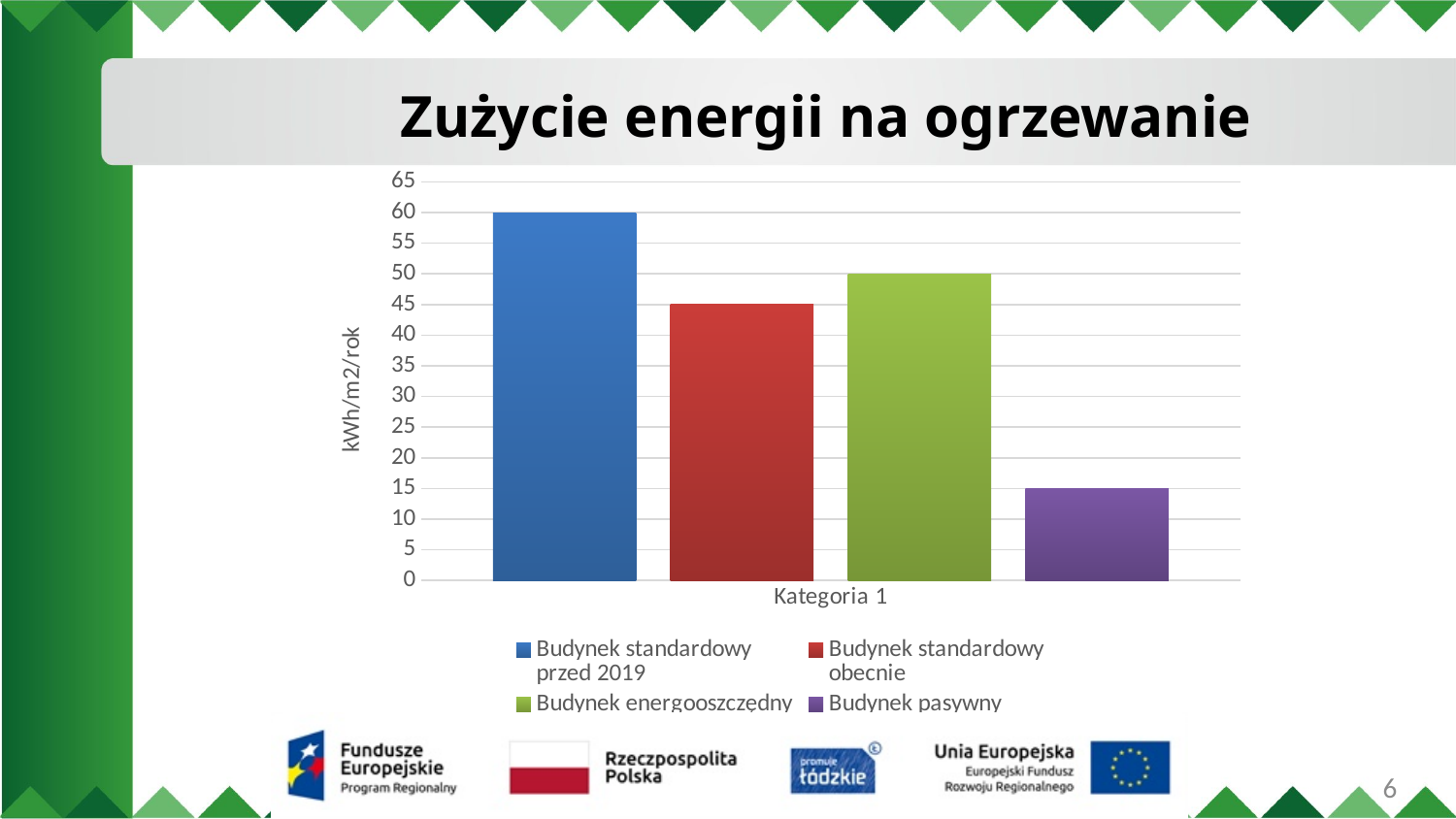
Which series has the lowest value? Budynek pasywny What kind of chart is shown? bar chart Is the value for Budynek standardowy obecnie greater or less than 40? greater What is the value for Budynek pasywny? 15 What is the value for Budynek standardowy przed 2019? 60 What is the title of the chart? Zużycie energii na ogrzewanie What is the difference between Budynek standardowy przed 2019 and Budynek standardowy obecnie? 15 Which is larger, Budynek energooszczędny or Budynek standardowy obecnie? Budynek energooszczędny What is the label on the vertical axis? kWh/m2/rok Which series has the highest value? Budynek standardowy przed 2019 What is the value for Budynek energooszczędny? 50 How many series does the legend list? 4